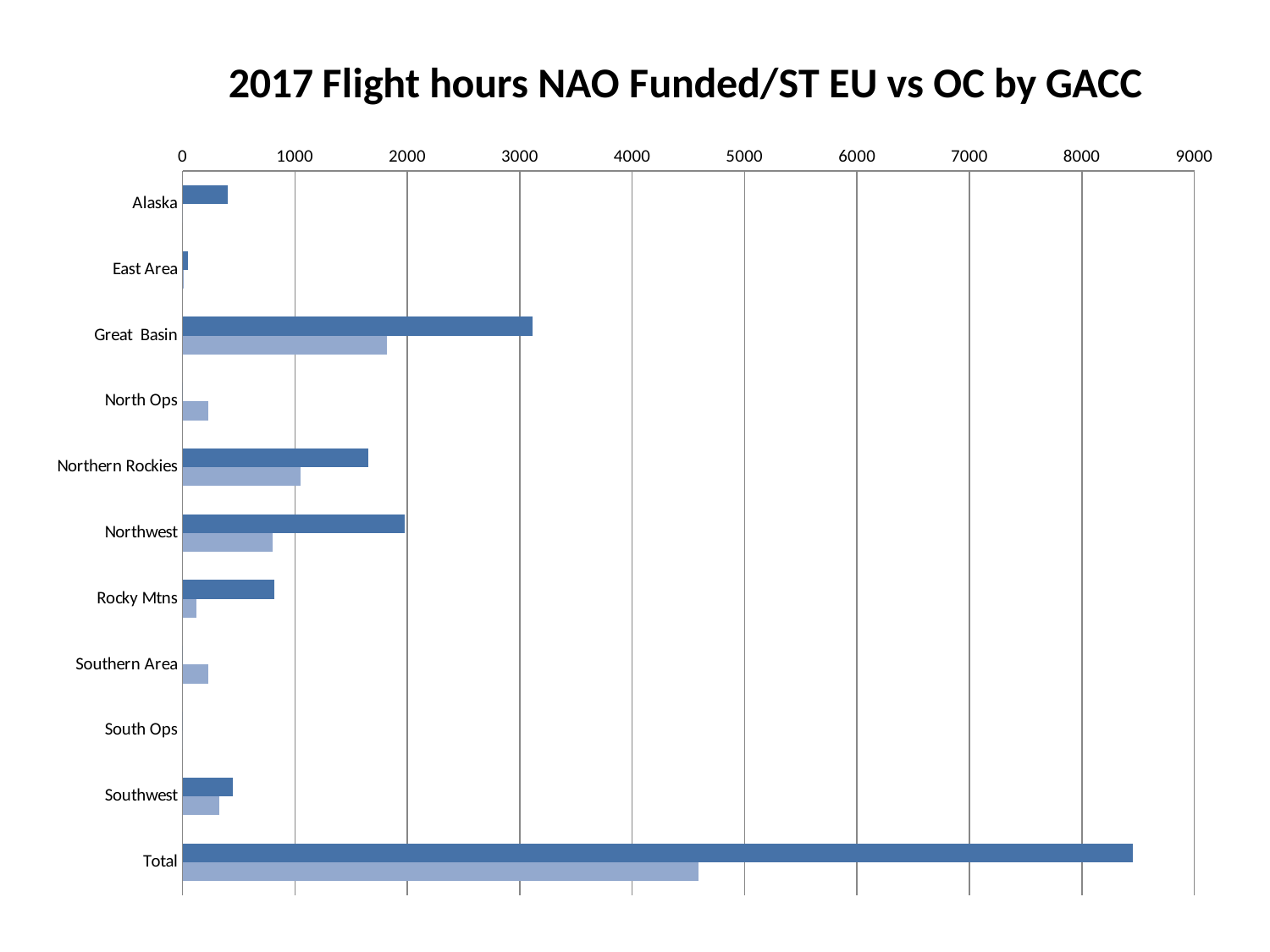
What is the highest value shown on the horizontal axis? 9000 Is the dark blue bar for Northern Rockies greater or less than 1000? greater Is the dark blue bar for Rocky Mtns greater or less than 1000? less Apart from Total, which category has the longest dark blue bar? Great Basin Is the dark blue bar for Total greater or less than 8000? greater How many categories are listed on the vertical axis of the chart? 11 For Great Basin, which bar is longer, the dark blue or the light blue? dark blue Which category has the longest dark blue bar? Total What is the title of the chart? 2017 Flight hours NAO Funded/ST EU vs OC by GACC What kind of chart is shown on the slide? bar chart